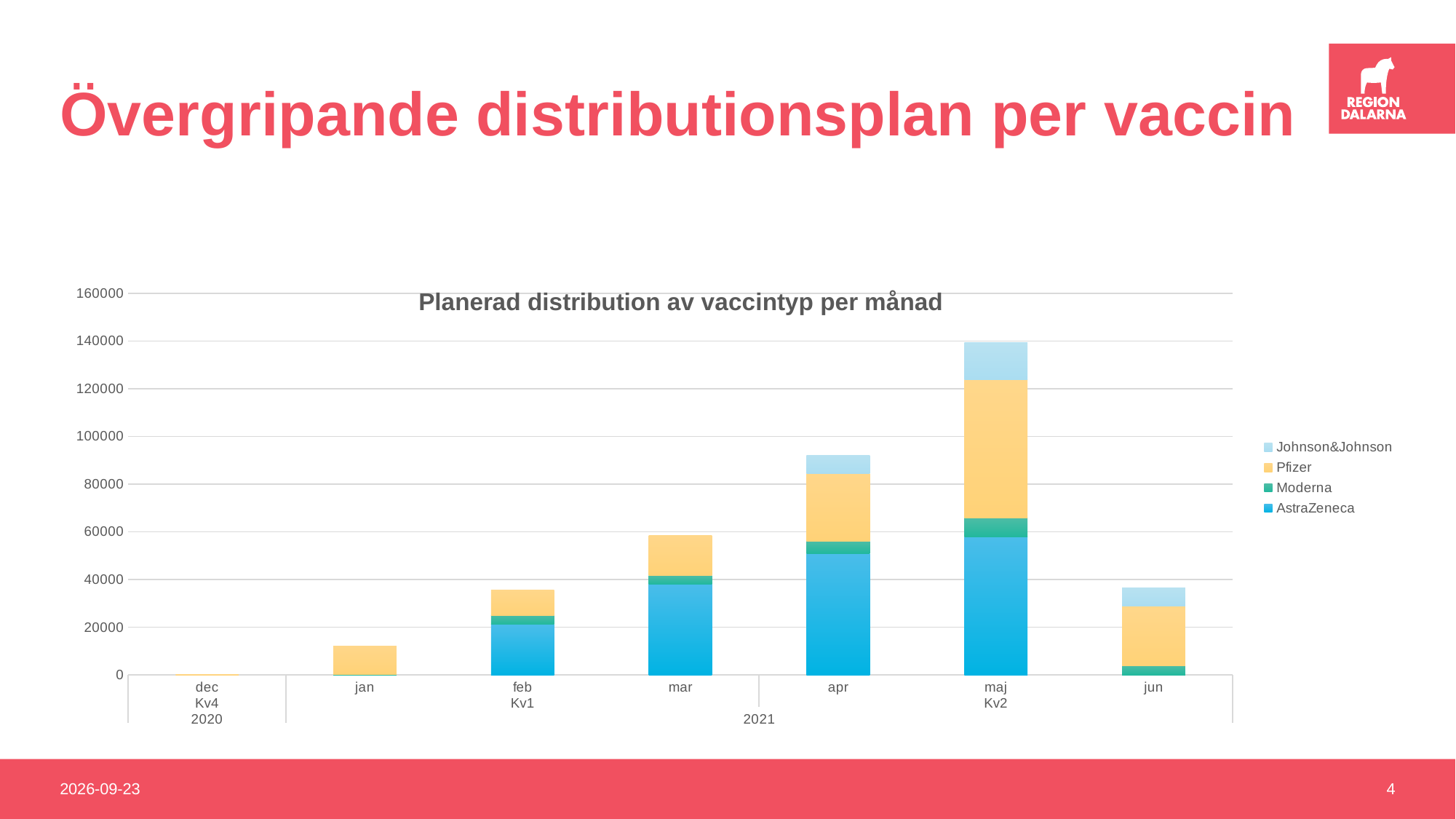
Is the AstraZeneca value for maj greater or less than 40000? greater How many series does the legend list? 4 How many months are shown on the x axis? 7 Do the total bar heights rise or fall from jan to maj? rise Is the total value for maj greater or less than 120000? greater Which month has the lowest total planned distribution? dec Which month has a larger total bar, feb or mar? mar What is the title of the chart? Planerad distribution av vaccintyp per månad What kind of chart is shown on the slide? Stacked bar chart Which month has the highest total planned distribution? maj Is the total value for apr greater or less than 80000? greater